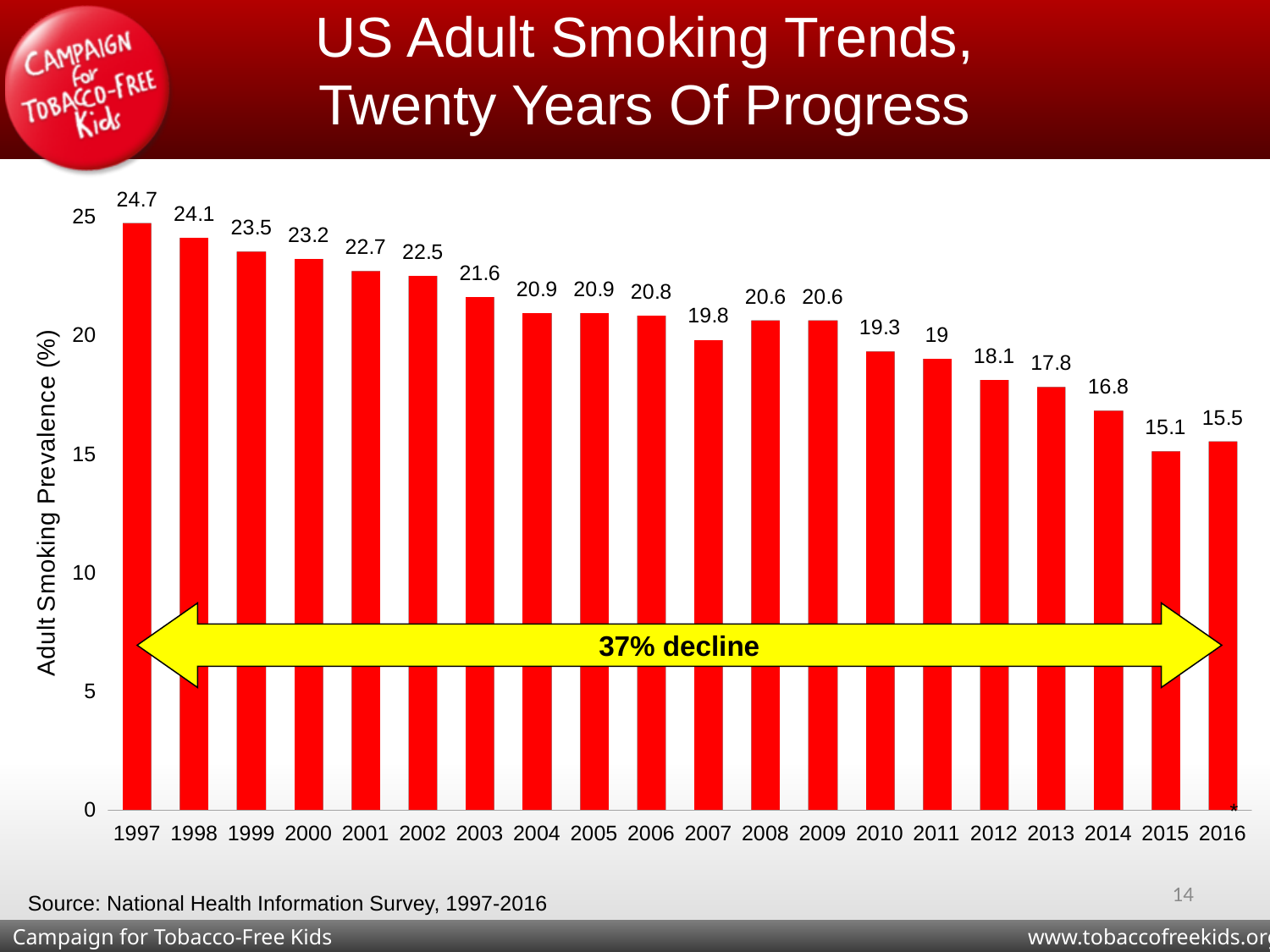
Is the value for 2012 greater or less than 20? less What is the difference in adult smoking prevalence between 1997 and 2016? 9.2 What is the adult smoking prevalence for 2007? 19.8 How many years are shown on the x axis? 20 What is the adult smoking prevalence for 1997? 24.7 What is the adult smoking prevalence for 2016? 15.5 What percentage decline is stated on the yellow arrow across the chart? 37% decline Which year has a higher adult smoking prevalence, 2003 or 2010? 2003 Which year has the highest adult smoking prevalence? 1997 Which year has the lowest adult smoking prevalence? 2015 Do the values rise or fall from 1997 to 2016? fall What kind of chart is shown on the slide? bar chart